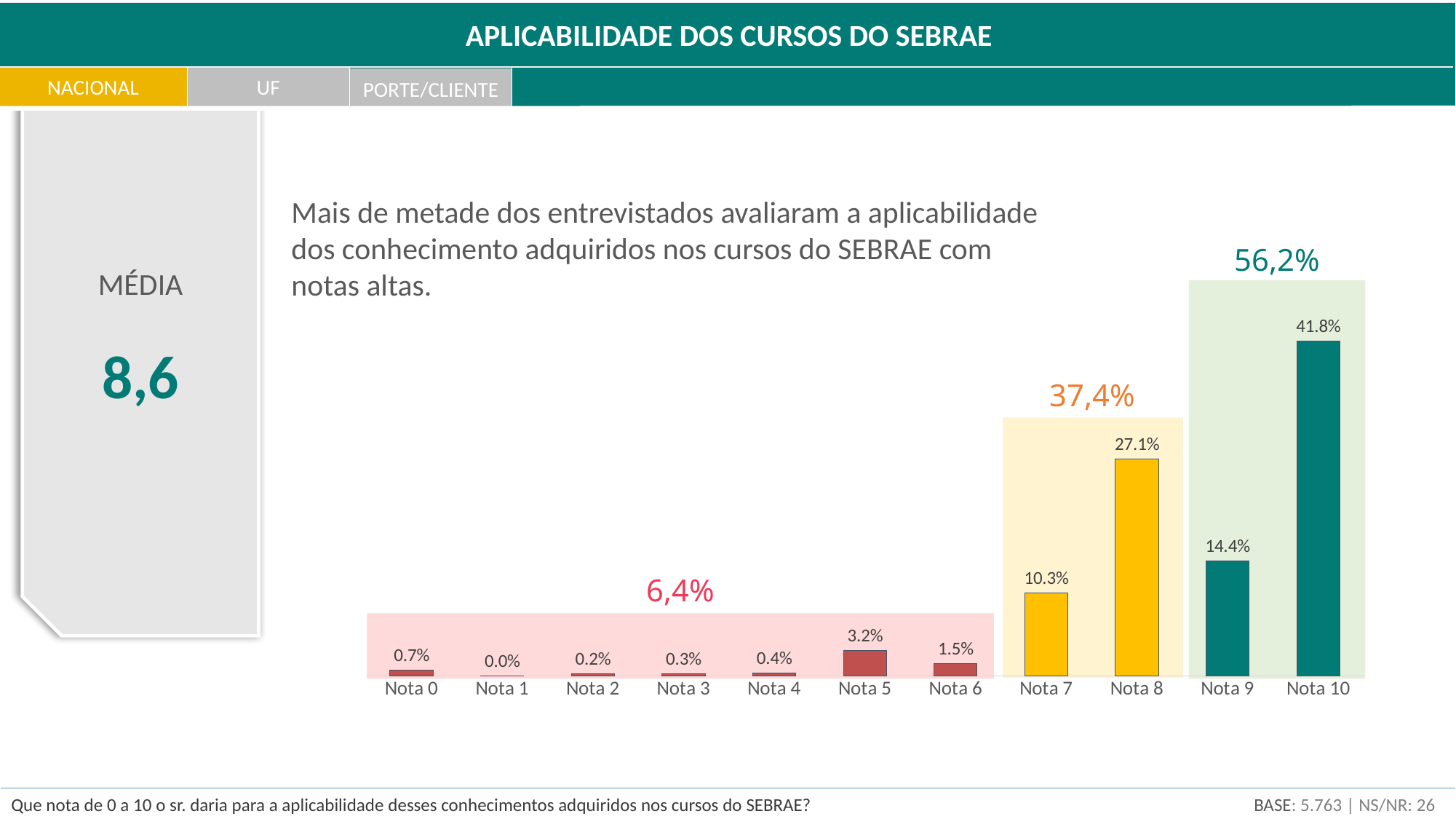
What is the value for Nota 10? 41.8% What is the combined share shown for the group Nota 0 to Nota 6? 6,4% What kind of chart is shown? Bar chart What is the value for Nota 5? 3.2% What is the difference between the values for Nota 10 and Nota 9? 27.4% Which category has the highest value? Nota 10 What is the value for Nota 8? 27.1% What is the value for Nota 7? 10.3% How many categories are shown on the x axis? 11 Which is larger, the value for Nota 8 or the value for Nota 9? Nota 8 What is the combined share shown for the group Nota 7 and Nota 8? 37,4% Which category has the lowest value? Nota 1